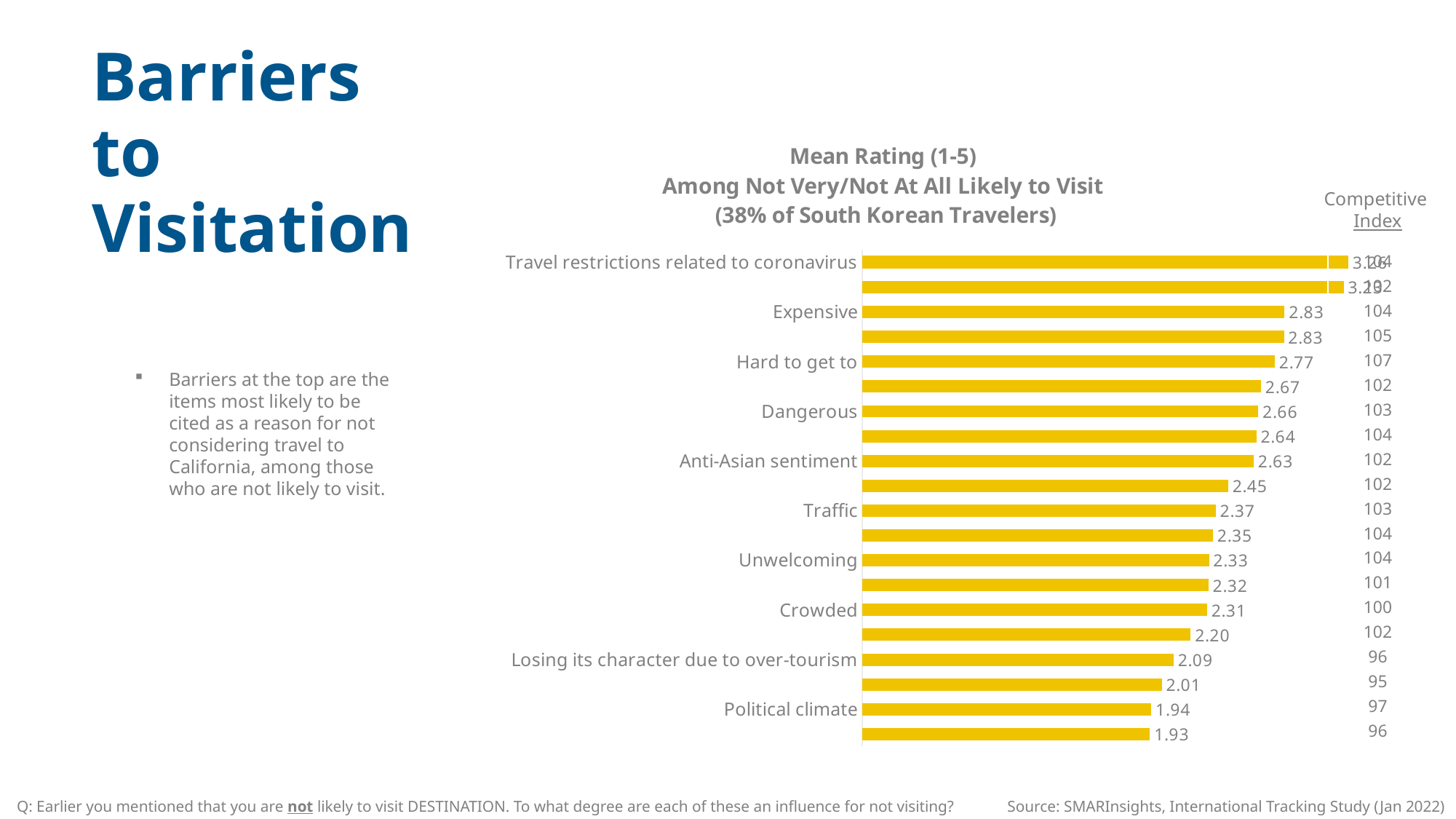
What kind of chart is shown on the slide? Bar chart Which has a higher mean rating, Expensive or Hard to get to? Expensive What is the mean rating for Hard to get to? 2.77 What is the lowest mean rating shown on the chart? 1.93 What is the Competitive Index value for Crowded? 100 How many bars are plotted on the chart? 20 What is the difference between the mean ratings for Crowded and Political climate? 0.37 What is the Competitive Index value for Hard to get to? 107 What is the mean rating for Political climate? 1.94 Which barrier has the highest mean rating? Travel restrictions related to coronavirus What is the mean rating for Anti-Asian sentiment? 2.63 What is the mean rating for Expensive? 2.83